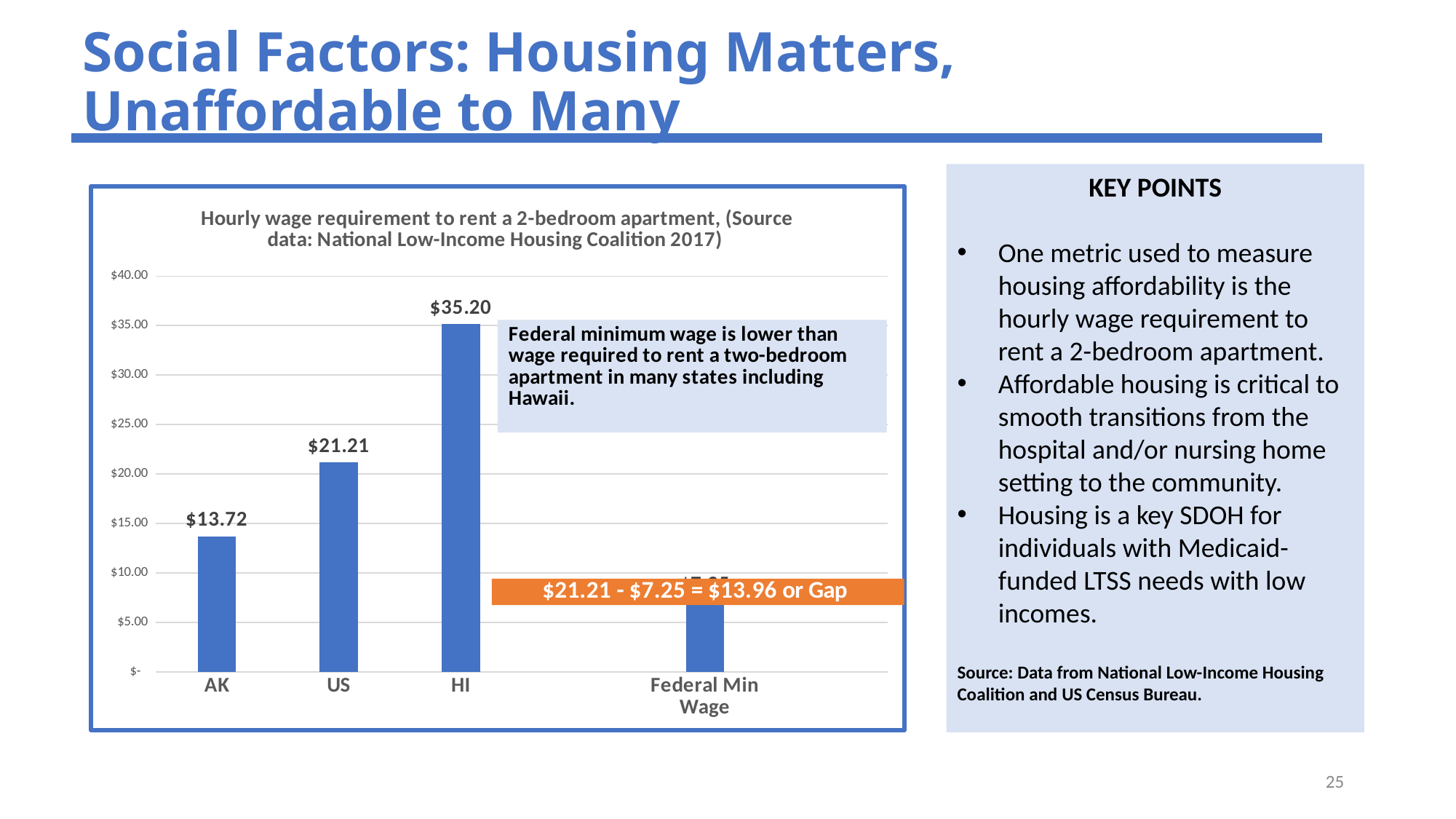
What is the hourly wage requirement shown for HI? $35.20 Which category has the lowest bar in the chart? Federal Min Wage Which category has the highest bar in the chart? HI Is the value for Federal Min Wage greater or less than $10.00? less What is the title of the chart? Hourly wage requirement to rent a 2-bedroom apartment, (Source data: National Low-Income Housing Coalition 2017) What is the hourly wage requirement shown for US? $21.21 What is the difference between the US value and the Federal Min Wage value, as stated on the chart? $13.96 How many categories are shown on the x axis of the chart? 4 What is the hourly wage requirement shown for AK? $13.72 What kind of chart is shown on the slide? bar chart Which is larger, the value for US or the value for AK? US What is the difference between the HI value and the AK value? $21.48